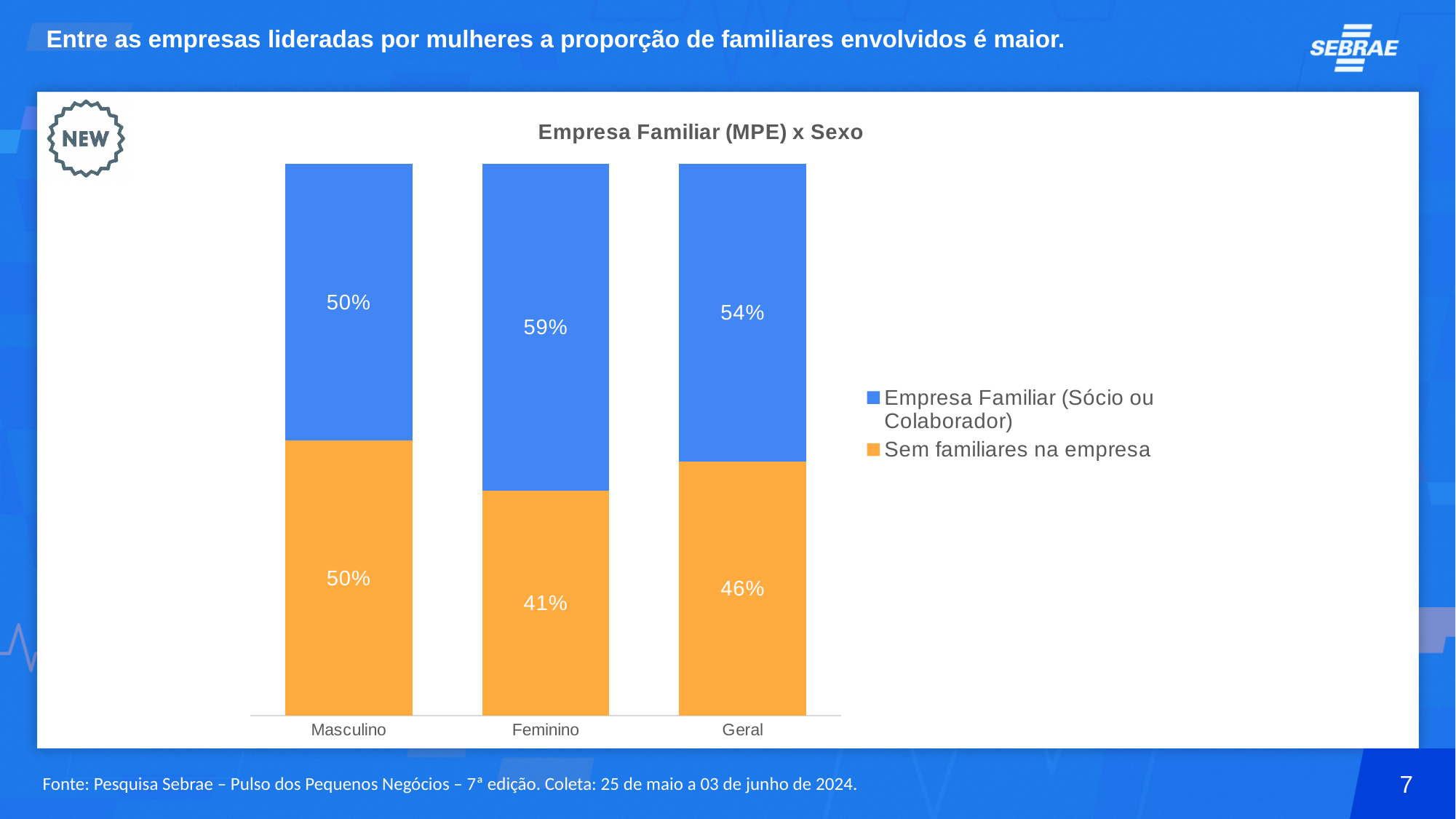
What kind of chart is shown on the slide? Stacked bar chart Which category has the lowest value for 'Sem familiares na empresa'? Feminino Which is larger: 'Sem familiares na empresa' for Geral or for Feminino? Geral What is the value for 'Sem familiares na empresa' in the Feminino category? 41% How many series does the legend list? 2 What is the value for 'Sem familiares na empresa' in the Masculino category? 50% What is the title of the chart? Empresa Familiar (MPE) x Sexo Which category has the highest value for 'Empresa Familiar (Sócio ou Colaborador)'? Feminino What is the value for 'Empresa Familiar (Sócio ou Colaborador)' in the Geral category? 54% What is the difference between the 'Empresa Familiar (Sócio ou Colaborador)' values for Feminino and Masculino? 9% What is the value for 'Empresa Familiar (Sócio ou Colaborador)' in the Feminino category? 59% How many categories are shown on the x axis? 3